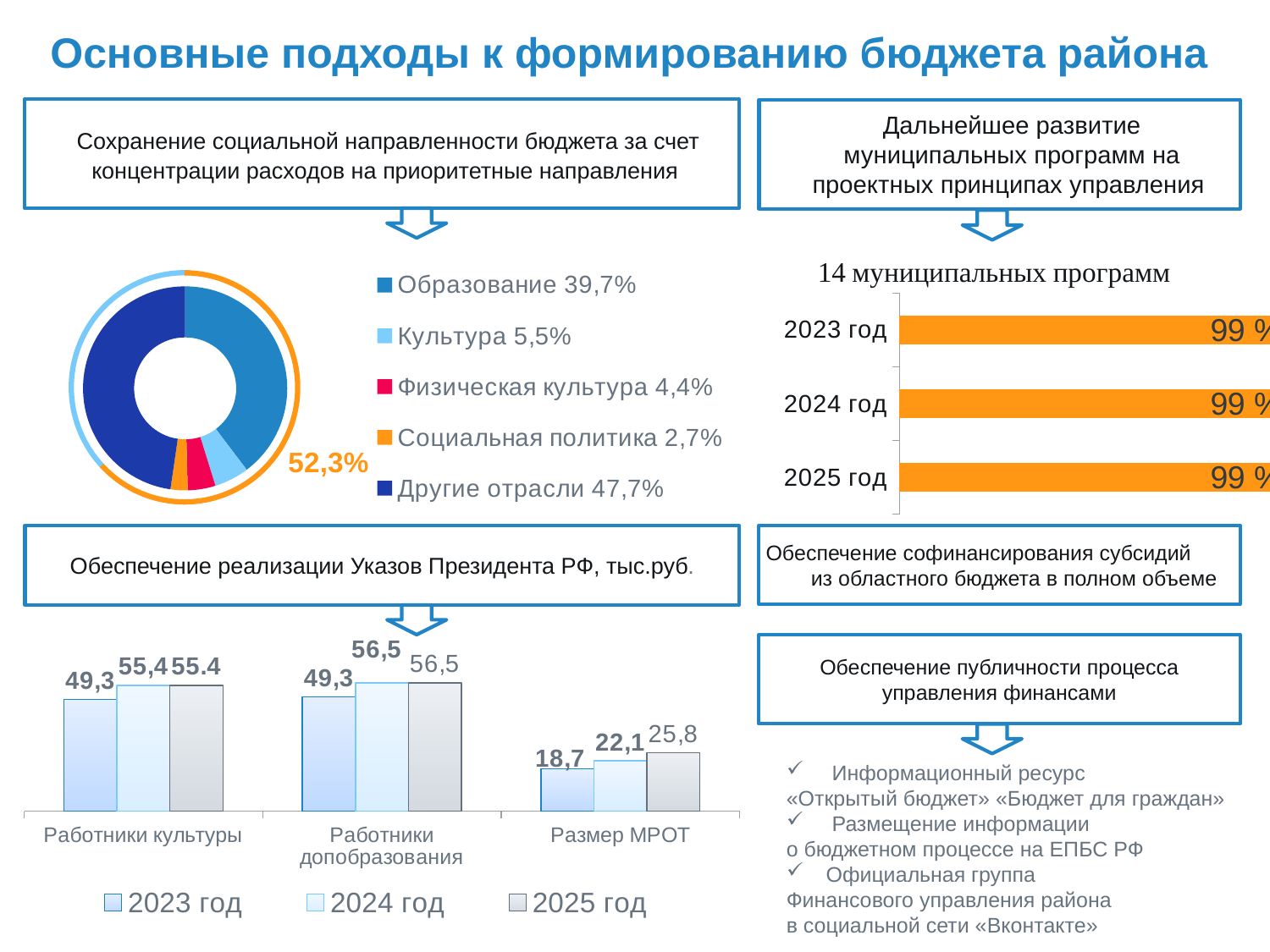
In the bottom-left bar chart, what is the difference between the Размер МРОТ values for 2024 год and 2023 год? 3,4 In the chart titled '14 муниципальных программ', what value is shown for 2024 год? 99 % In the bottom-left bar chart, which category has the lowest value for 2023 год? Размер МРОТ What kind of chart is the chart on the left under the first box? Doughnut (pie) chart How many series does the legend of the bottom-left bar chart list? 3 In the doughnut chart on the left, which category has the largest share? Другие отрасли How many bars does the chart titled '14 муниципальных программ' show? 3 In the bottom-left bar chart, what is the value for Размер МРОТ in 2025 год? 25,8 In the doughnut chart on the left, what share is shown for Образование? 39,7% In the bottom-left bar chart, do the values for Размер МРОТ rise or fall from 2023 год to 2025 год? Rise How many categories does the doughnut chart on the left show? 5 In the doughnut chart on the left, which category has the smallest share? Социальная политика